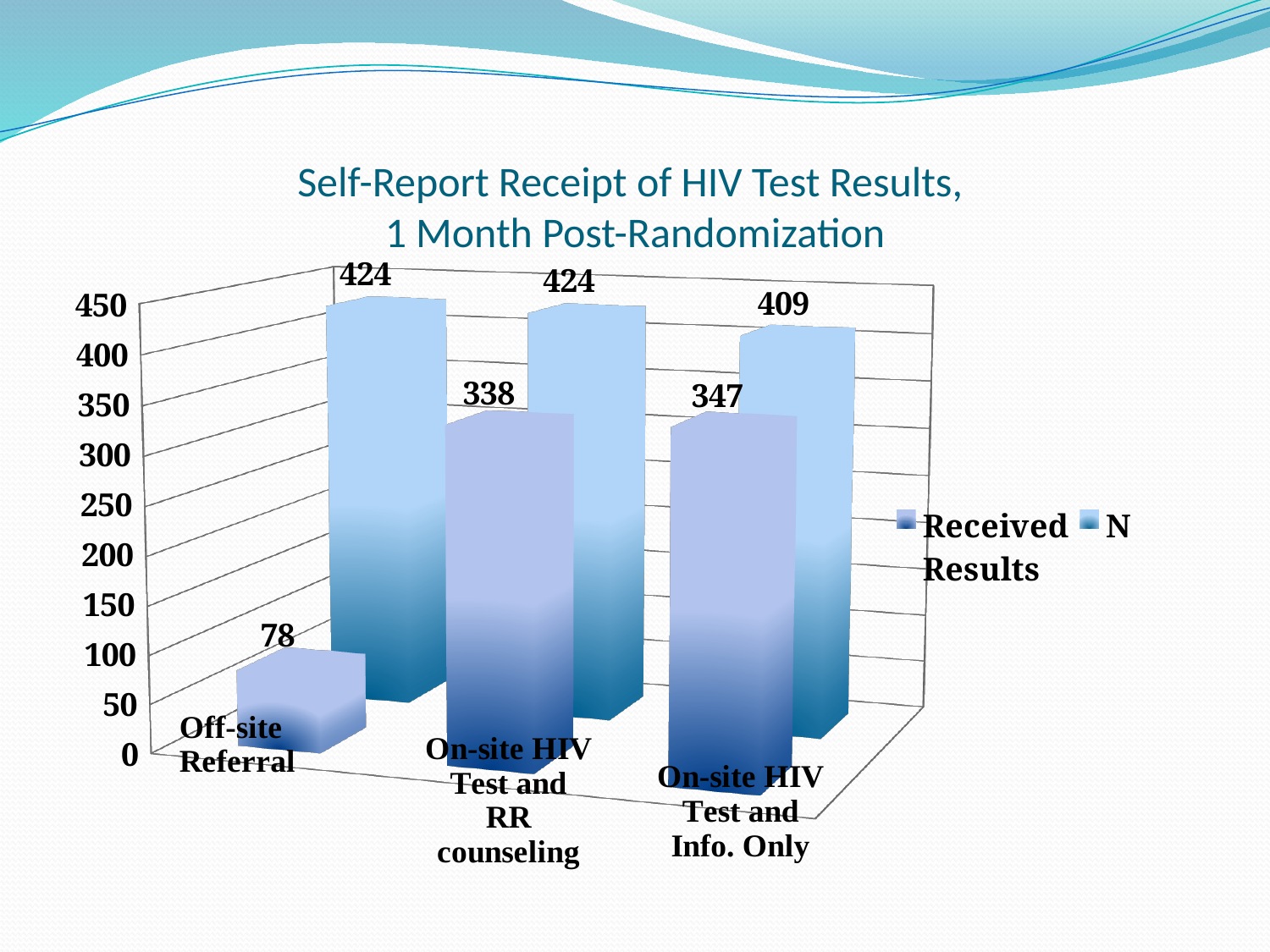
Which is larger: the N value for Off-site Referral or the N value for On-site HIV Test and Info. Only? Off-site Referral What is the N value for Off-site Referral? 424 What kind of chart is shown on the slide? Bar chart What is the N value for On-site HIV Test and Info. Only? 409 Which category has the highest Received Results value? On-site HIV Test and Info. Only What is the Received Results value for On-site HIV Test and RR counseling? 338 How many series does the legend list? 2 Which category has the lowest Received Results value? Off-site Referral What is the Received Results value for Off-site Referral? 78 How many categories are shown on the x axis? 3 What is the difference between the Received Results values for On-site HIV Test and Info. Only and Off-site Referral? 269 What is the difference between N and Received Results for On-site HIV Test and RR counseling? 86